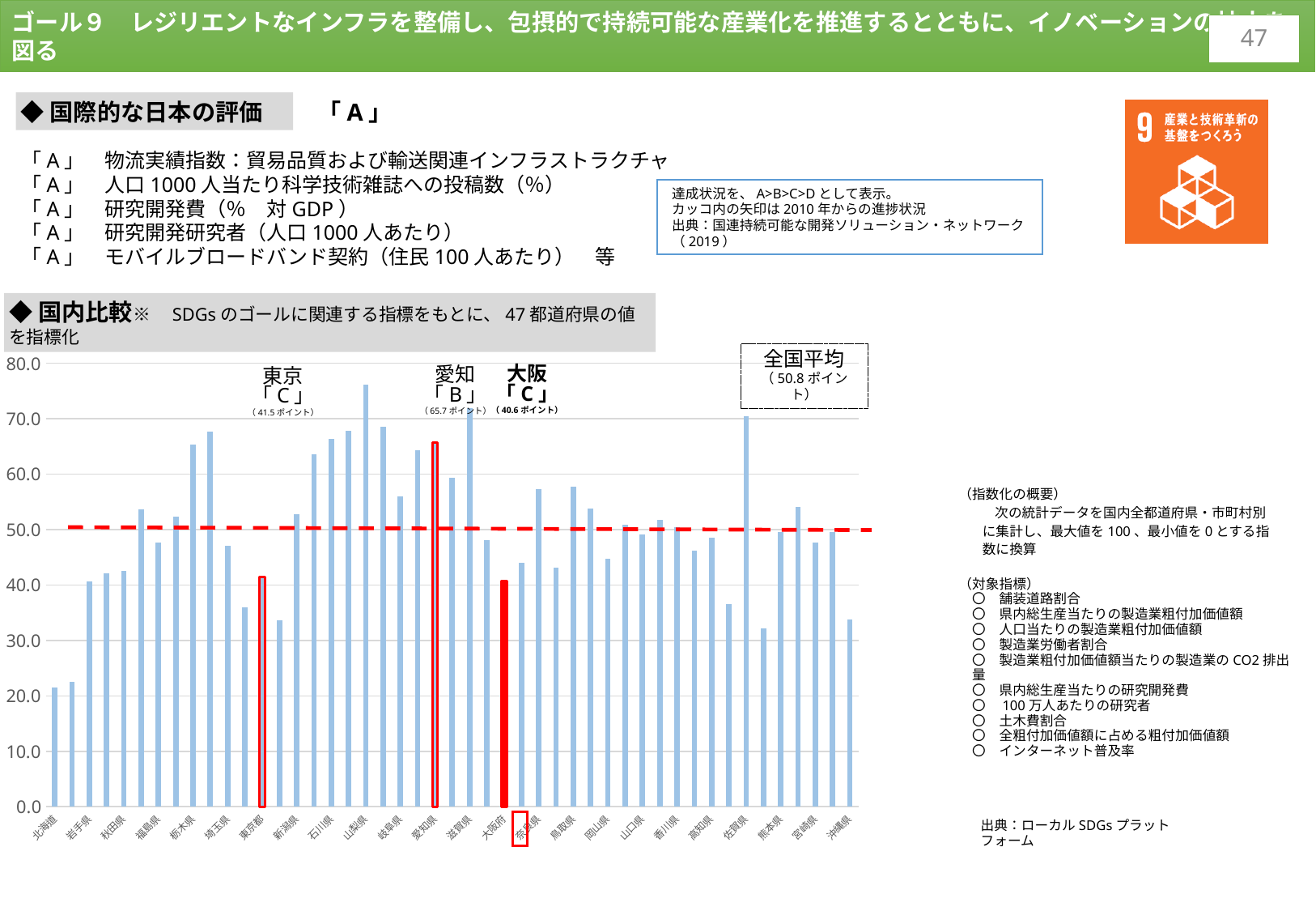
What kind of chart is shown on the slide? bar chart What grade is shown for 愛知 on the chart? B Which has the larger printed value, 愛知 or 大阪? 愛知 What is the 全国平均 value shown on the chart? 50.8 ポイント What value is printed for 東京 on the chart? 41.5 ポイント What does the red dashed horizontal line on the chart represent? 全国平均 (50.8 ポイント) Is the value for 北海道 greater or less than 30.0? less What value is printed for 愛知 on the chart? 65.7 ポイント What is the difference between the printed values for 愛知 and 東京? 24.2 ポイント Is the value for 佐賀県 greater or less than 60.0? greater Is the value for 沖縄県 greater or less than 40.0? less What value is printed for 大阪 on the chart? 40.6 ポイント